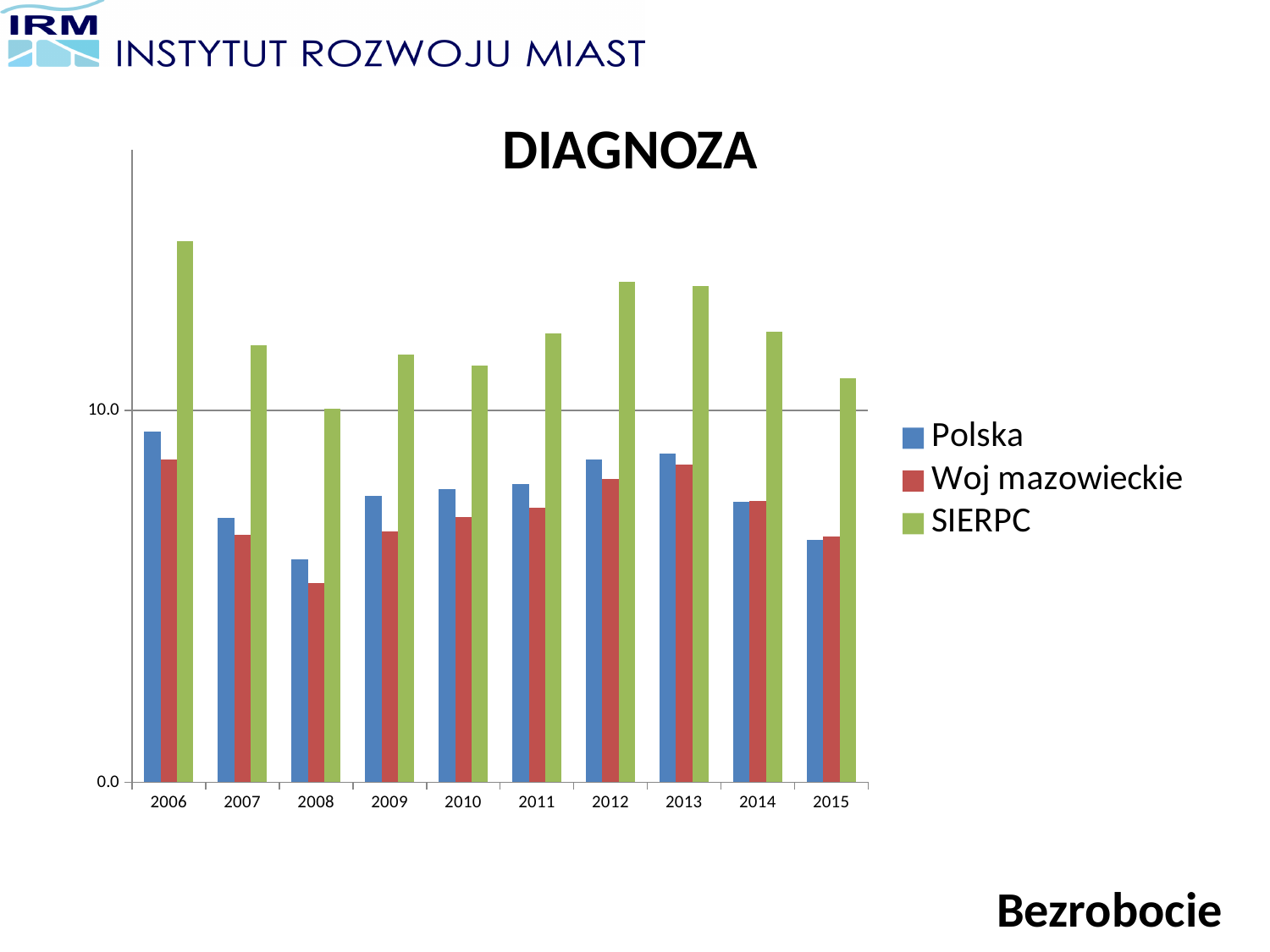
Is the value for SIERPC in 2006 greater or less than 10.0? greater In which year is the Polska value highest? 2006 Is the value for Polska in 2015 greater or less than 10.0? less Which series is shown in green? SIERPC In 2006, which is larger: Polska or Woj mazowieckie? Polska Which series has the highest value in every year shown? SIERPC How many years are shown on the x axis? 10 What kind of chart is shown on the slide? bar chart What is the title of the chart? DIAGNOZA In which year is the SIERPC value highest? 2006 In which year is the Woj mazowieckie value lowest? 2008 How many series does the legend list? 3